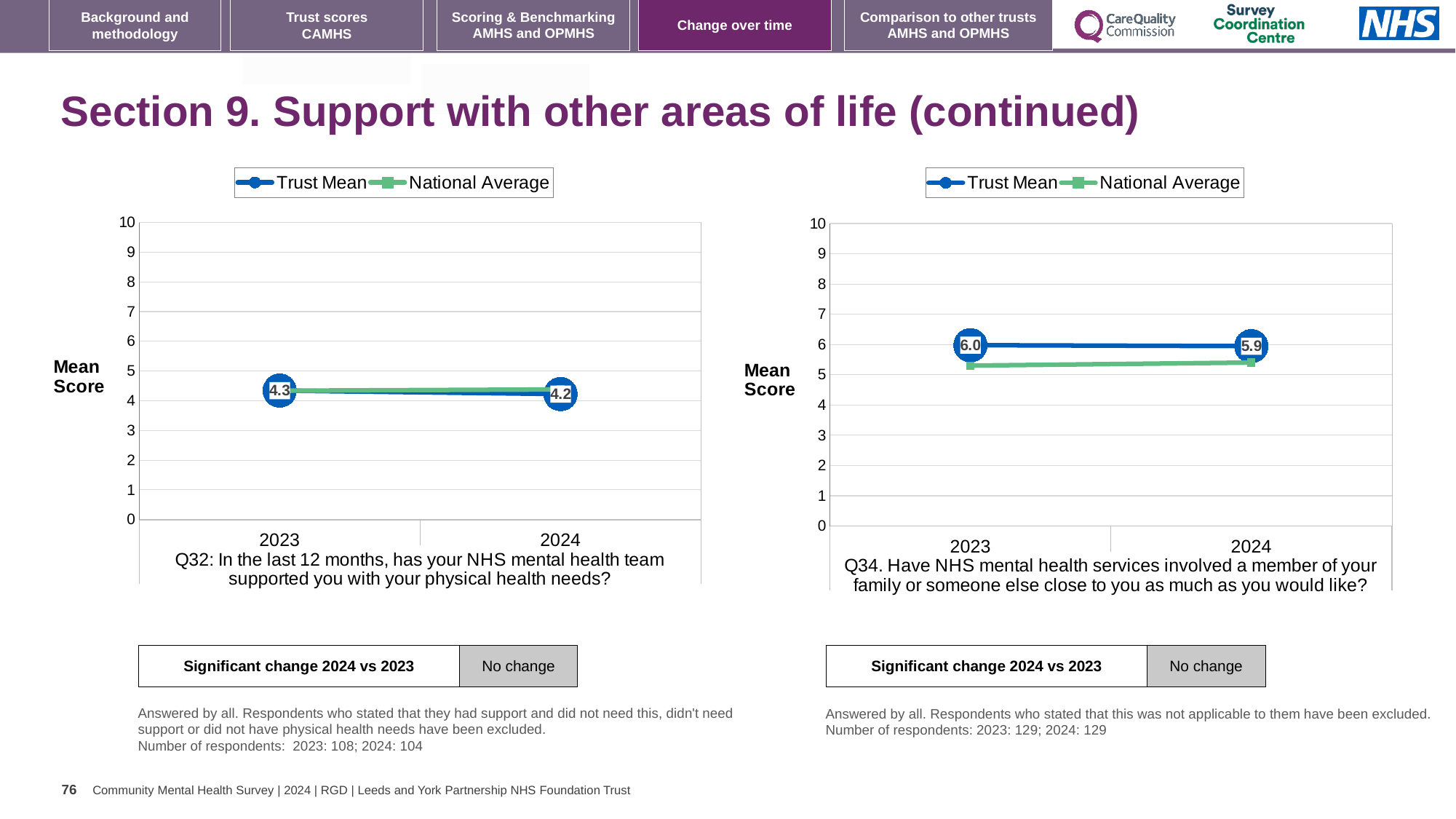
In the right chart (Q34), is the National Average for 2023 greater or less than 6? less In the left chart (Q32), is the Trust Mean for 2024 greater or less than 5? less In the right chart (Q34), what is the Trust Mean for 2024? 5.9 How many series does the legend of the left chart (Q32) list? 2 What kind of chart is the left chart (Q32)? line chart In the right chart (Q34), is the Trust Mean in 2023 greater or less than the National Average in 2023? greater In the right chart (Q34), what is the Trust Mean for 2023? 6.0 In the right chart (Q34), what is the difference between the Trust Mean in 2023 and in 2024? 0.1 In the left chart (Q32), what is the Trust Mean for 2023? 4.3 In the left chart (Q32), what is the Trust Mean for 2024? 4.2 In the left chart (Q32), does the Trust Mean rise or fall from 2023 to 2024? fall How many years are shown on the x axis of the right chart (Q34)? 2